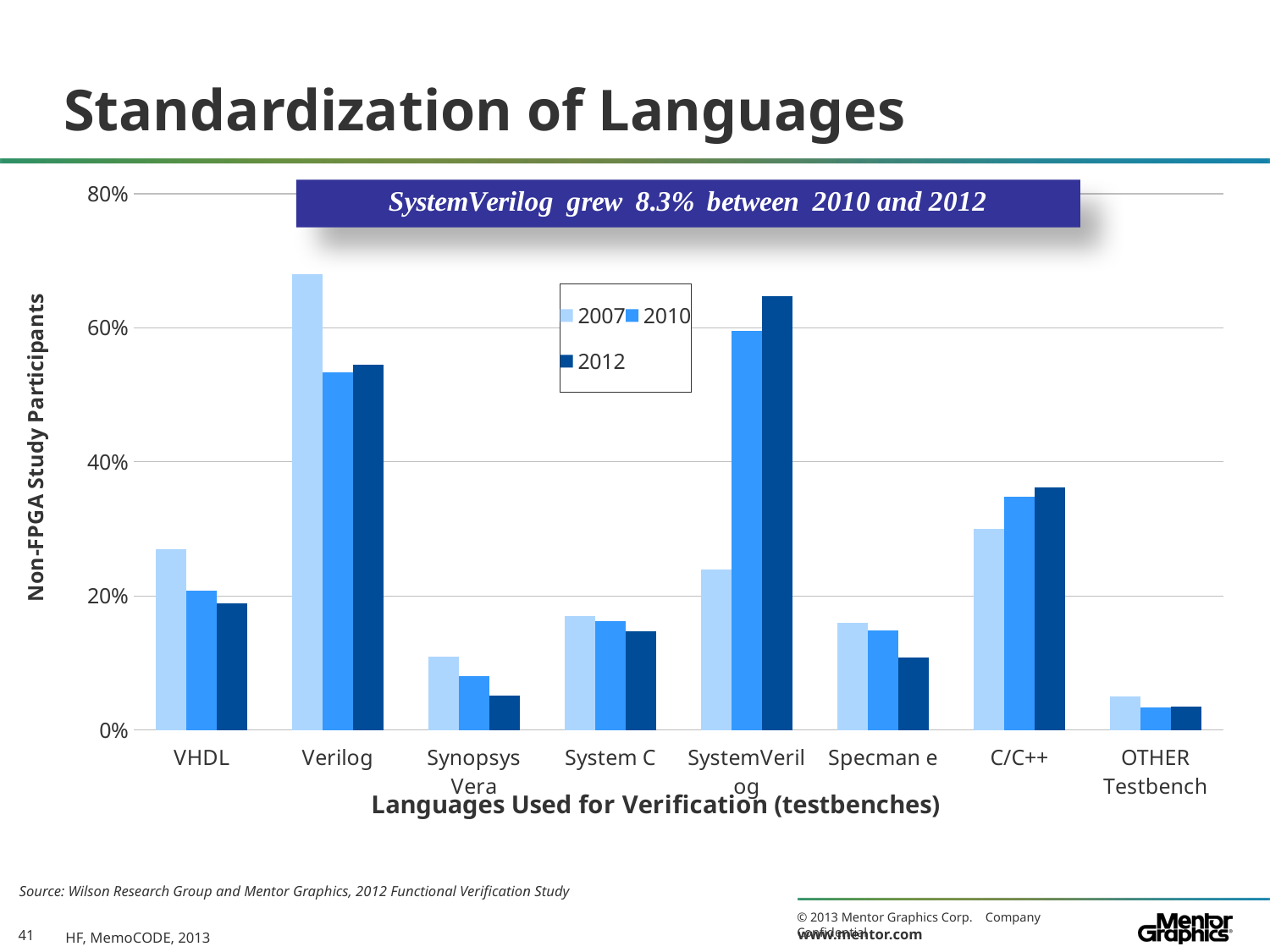
Is the 2012 value for C/C++ greater or less than 40%? less Is the 2007 value for VHDL greater or less than 20%? greater Which is larger for 2012: Verilog or SystemVerilog? SystemVerilog How many series does the legend list? 3 How many language categories are shown on the x axis? 8 Which language has the highest 2012 value? SystemVerilog According to the callout on the chart, by how much did SystemVerilog grow between 2010 and 2012? 8.3% What type of chart is shown on the slide? bar chart Which language has the lowest 2007 value? OTHER Testbench Which language has the highest 2007 value? Verilog Do the values for SystemVerilog rise or fall from 2007 to 2012? rise Is the 2007 value for Verilog greater or less than 60%? greater